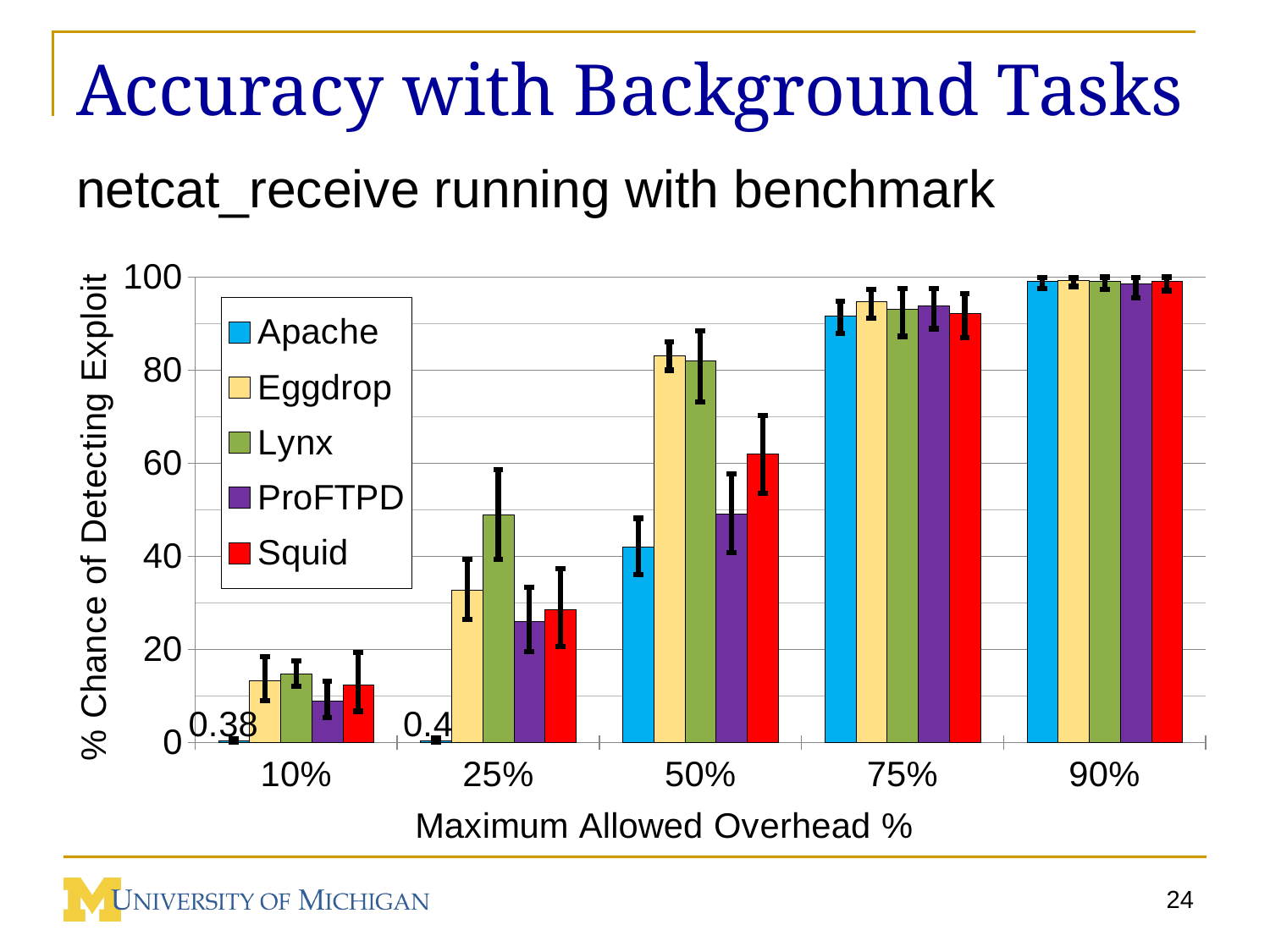
Which series has the highest value at 25% maximum allowed overhead? Lynx Which series has the lowest value at 50% maximum allowed overhead? Apache At 50% maximum allowed overhead, which is larger: Apache or Eggdrop? Eggdrop Is the value for ProFTPD at 10% maximum allowed overhead greater or less than 20? less Is the value for Eggdrop at 50% maximum allowed overhead greater or less than 60? greater What is the value for Apache at 10% maximum allowed overhead? 0.38 Is the value for Apache at 50% maximum allowed overhead greater or less than 60? less What kind of chart is shown on the slide? bar chart How many series does the legend list? 5 What is the value for Apache at 25% maximum allowed overhead? 0.4 Do the values for Apache rise or fall as maximum allowed overhead increases along the x axis? rise How many maximum allowed overhead categories are shown on the x axis? 5